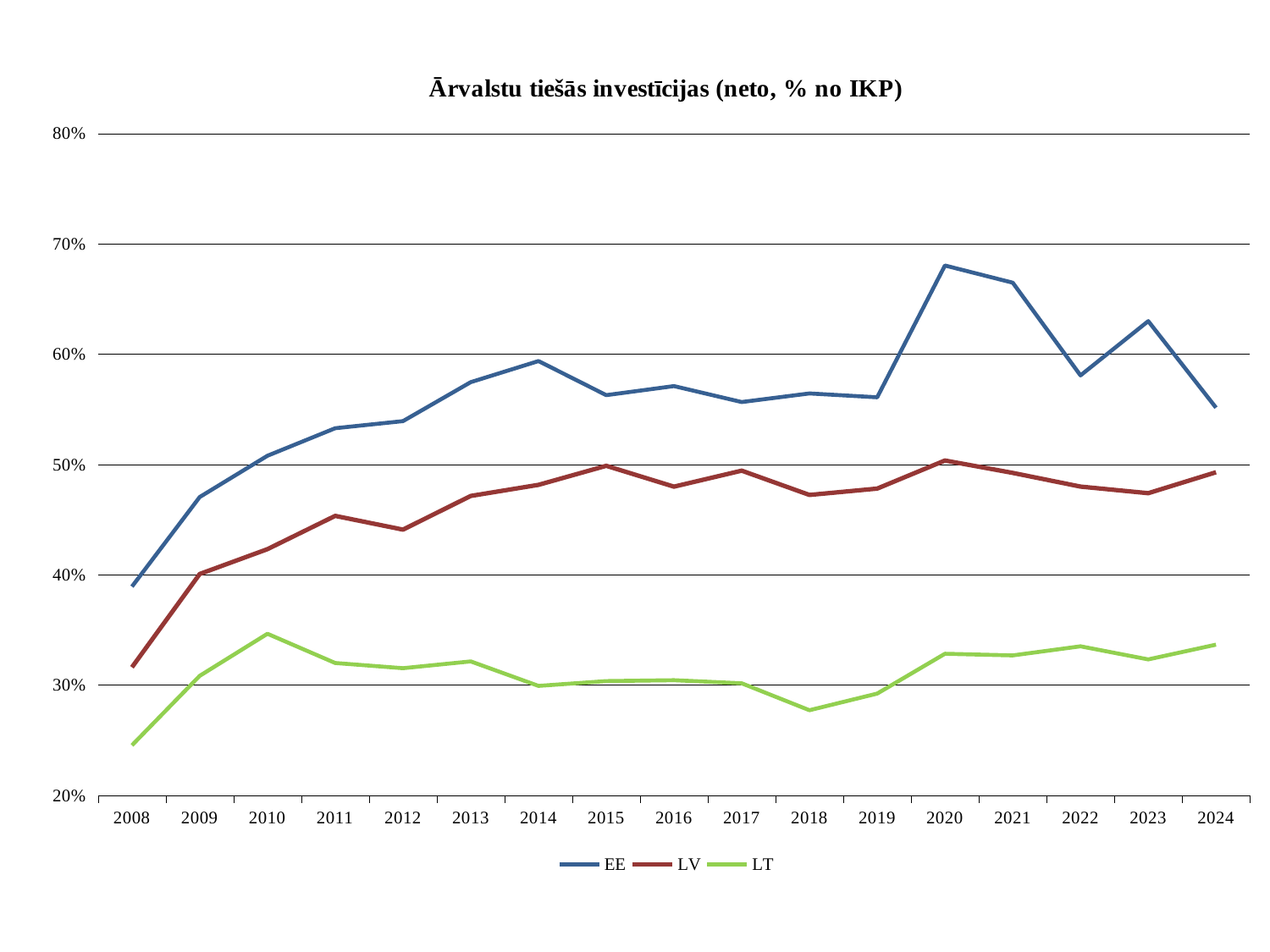
In which year does the LT series have its lowest value? 2008 Is the value for EE in 2020 greater or less than 60%? greater In which year does the EE series have its lowest value? 2008 What kind of chart is shown on the slide? line chart Which series has the highest value in 2024? EE Does the EE series rise or fall from 2008 to 2014? rise In which year does the EE series reach its highest value? 2020 Is the value for LT in 2018 greater or less than 30%? less What is the title of the chart? Ārvalstu tiešās investīcijas (neto, % no IKP) Is the value for LV in 2008 greater or less than 40%? less How many series does the legend list? 3 How many years are plotted along the x axis? 17